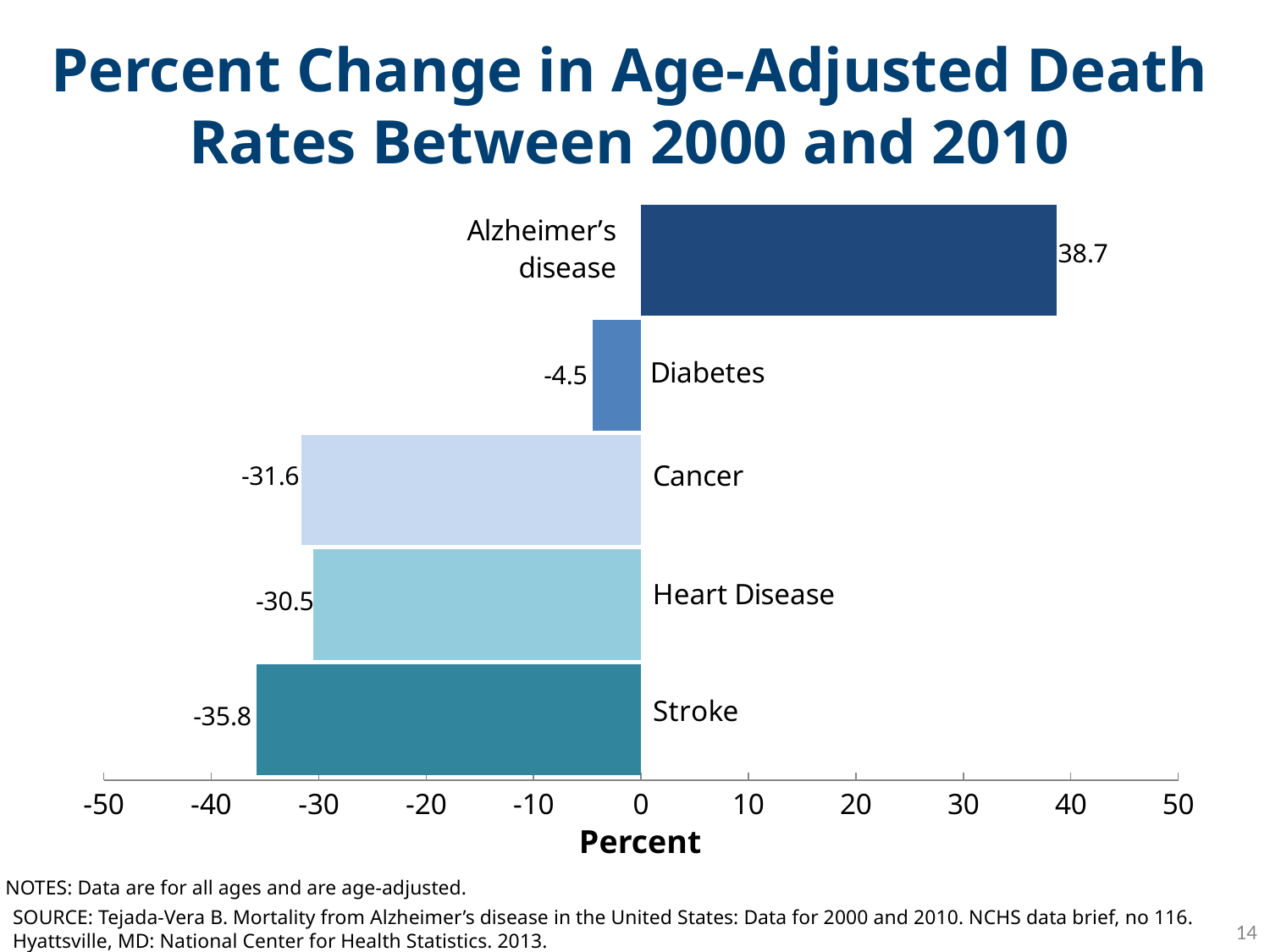
Which cause of death has the lowest percent change? Stroke What is the percent change in age-adjusted death rate for Stroke? -35.8 What is the label of the horizontal axis? Percent Which cause of death has the highest percent change? Alzheimer's disease Is the value for Stroke greater or less than -30? less What is the percent change in age-adjusted death rate for Alzheimer's disease? 38.7 What is the percent change in age-adjusted death rate for Cancer? -31.6 What is the difference between the percent change for Cancer and Heart Disease? 1.1 What kind of chart is shown on the slide? Bar chart Which has a larger percent change, Diabetes or Heart Disease? Diabetes How many causes of death are shown in the chart? 5 What is the percent change in age-adjusted death rate for Diabetes? -4.5